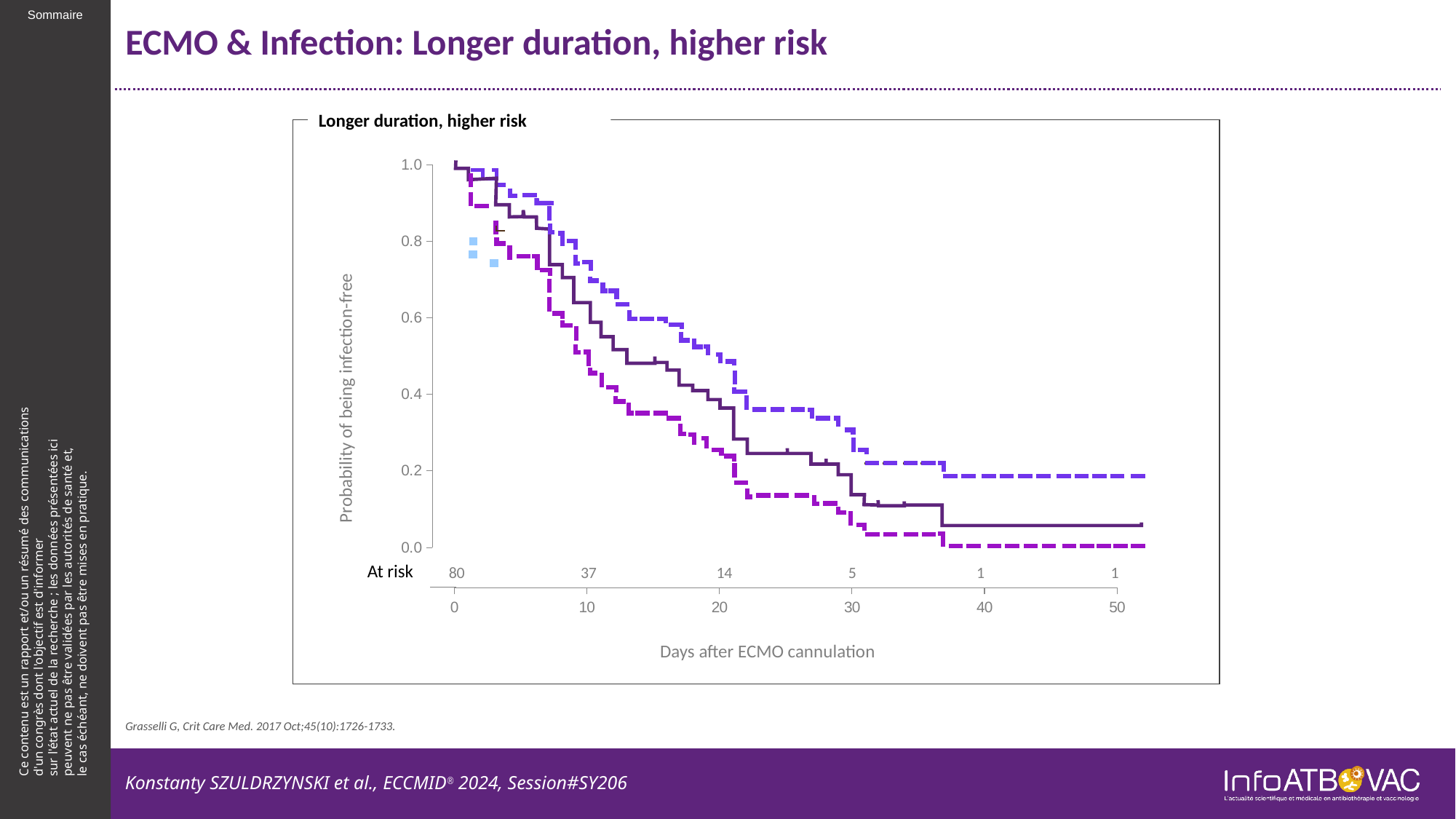
What is the label of the x axis of the chart? Days after ECMO cannulation What is the difference between the number at risk at day 0 and at day 10? 43 How many patients are at risk at day 10? 37 How many time points are listed in the 'At risk' row? 6 What is the title of the chart? Longer duration, higher risk What kind of chart is shown on the slide? line chart How many patients are at risk at day 30? 5 How many patients are at risk at day 20? 14 At which day is the number at risk highest? 0 Which has more patients at risk, day 10 or day 20? day 10 How many patients are at risk at day 0? 80 Does the probability of being infection-free rise or fall as days after ECMO cannulation increase? fall